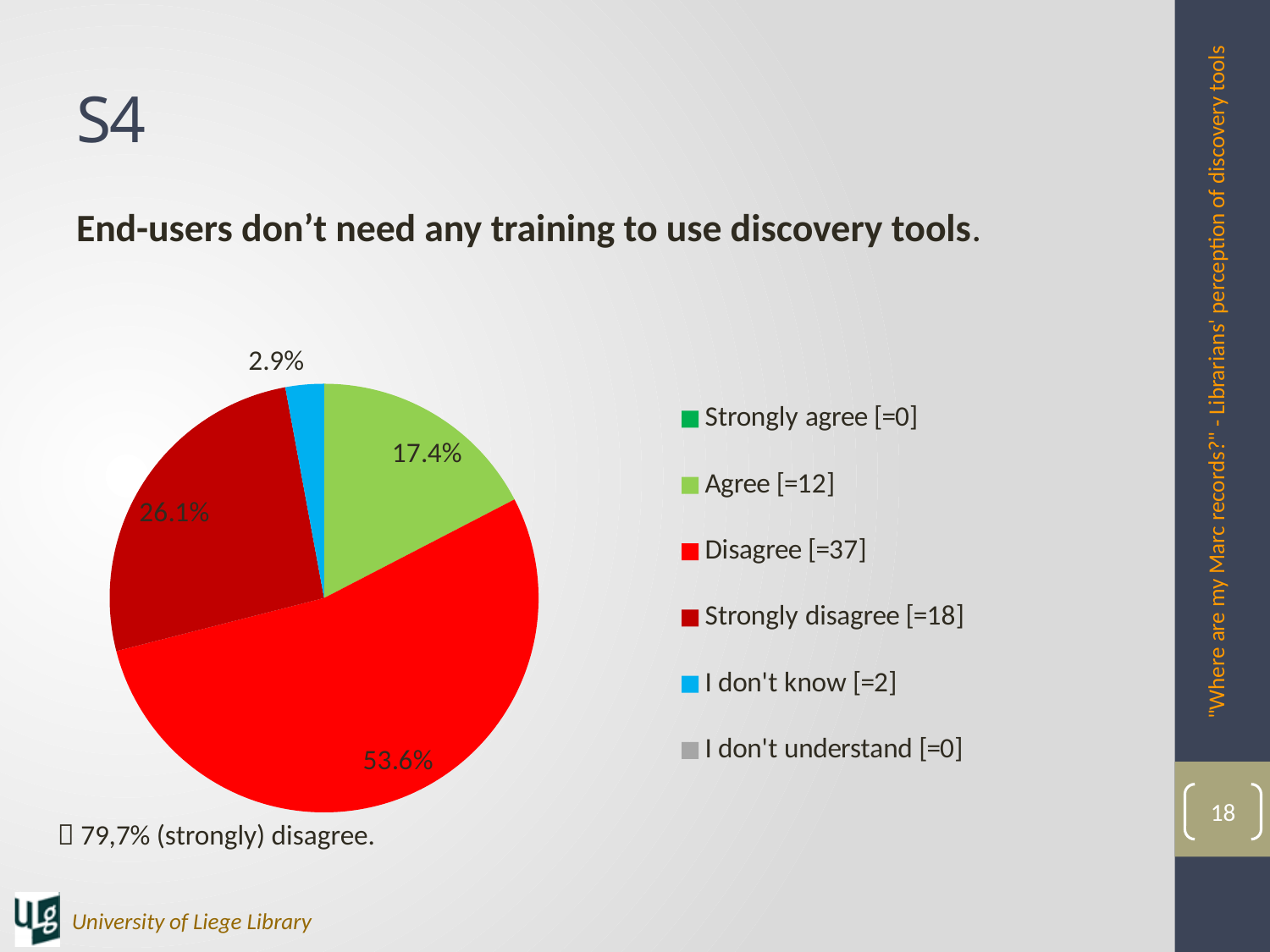
Which slice is larger, Agree or Strongly disagree? Strongly disagree What colour is the Strongly disagree slice? dark red What kind of chart is shown on the slide? pie chart What percentage of the pie is labelled for the Disagree slice? 53.6% What percentage of the pie is labelled for the I don't know slice? 2.9% Which response has the largest slice of the pie? Disagree What percentage of the pie is labelled for the Strongly disagree slice? 26.1% Which response with a visible slice has the smallest share of the pie? I don't know How many entries does the legend list? 6 What percentage of the pie is labelled for the Agree slice? 17.4% According to the legend, how many respondents answered Disagree? 37 What is the difference in percentage points between the Disagree slice and the Strongly disagree slice? 27.5